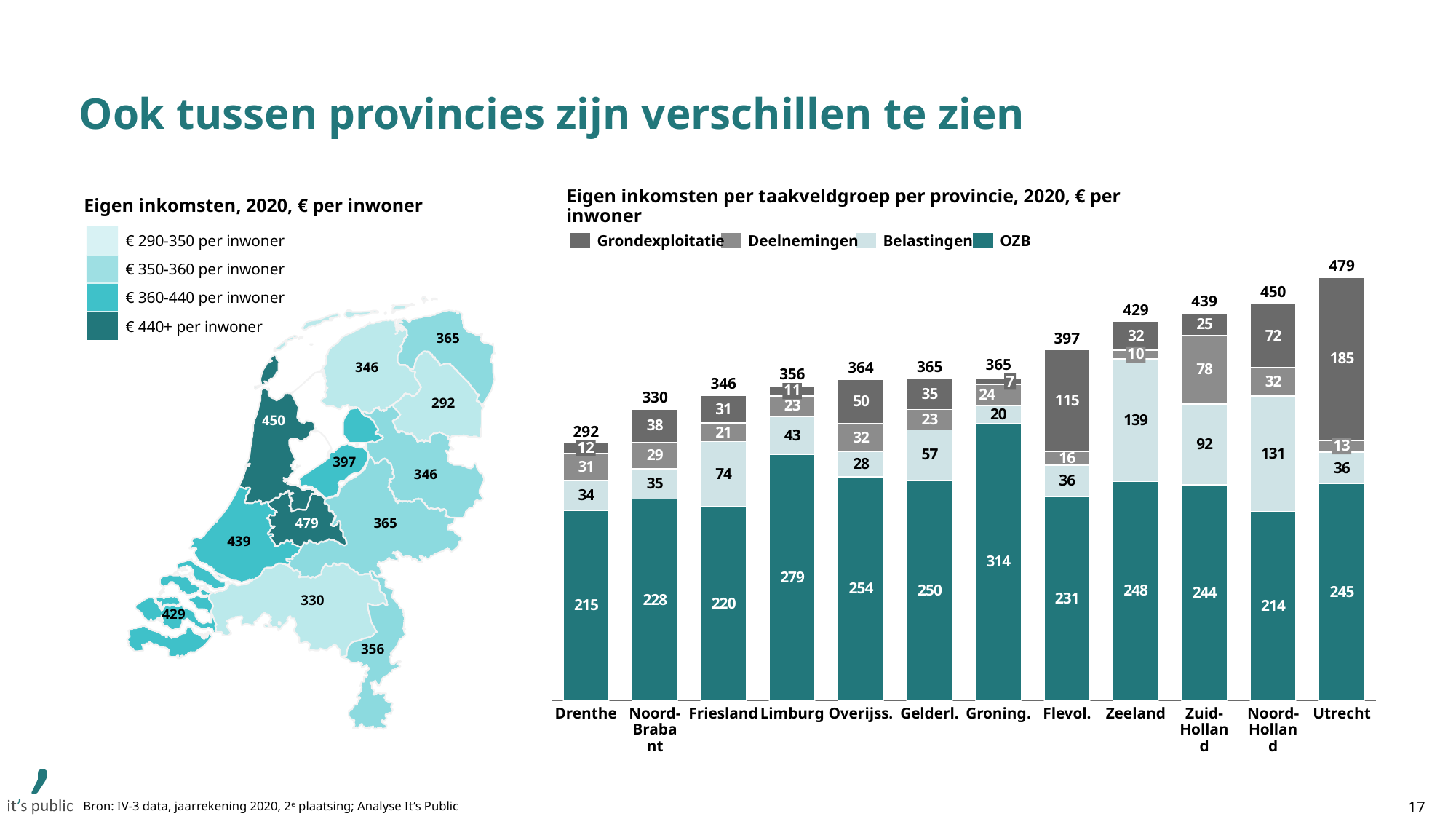
In the stacked bar chart on the right, how many provinces are shown on the x axis? 12 In the stacked bar chart on the right, what is the OZB value for Groningen? 314 In the stacked bar chart on the right, what is the total of the stacked bar for Flevoland? 397 In the stacked bar chart on the right, what is the difference between the totals for Utrecht and Drenthe? 187 What kind of chart is shown on the right side of the slide? Stacked bar chart In the stacked bar chart on the right, what is the Grondexploitatie value for Utrecht? 185 In the stacked bar chart on the right, how many series does the legend list? 4 In the stacked bar chart on the right, which province has the lowest total eigen inkomsten per inwoner? Drenthe In the stacked bar chart on the right, what is the Belastingen value for Zeeland? 139 In the stacked bar chart on the right, which series is shown in dark teal at the bottom of each bar? OZB In the stacked bar chart on the right, which is larger: the OZB value for Limburg or the OZB value for Noord-Holland? Limburg In the stacked bar chart on the right, which province has the highest total eigen inkomsten per inwoner? Utrecht